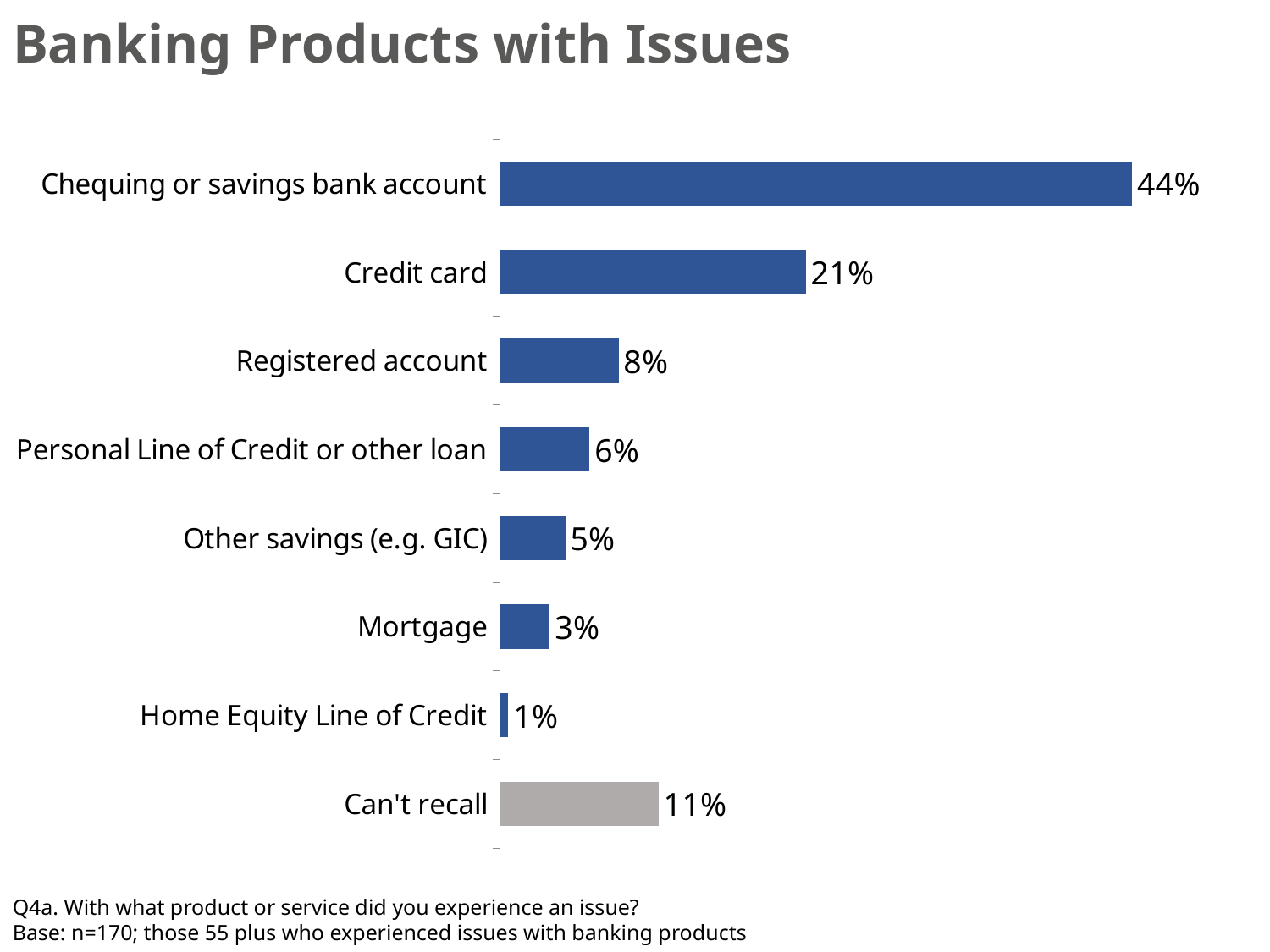
What is the difference between the values for Chequing or savings bank account and Credit card? 23% What is the value for Mortgage? 3% What percentage is shown for Can't recall? 11% What type of chart is shown on the slide? Bar chart What is the difference between Registered account and Other savings (e.g. GIC)? 3% What is the value for Credit card? 21% What percentage is shown for Chequing or savings bank account? 44% How many categories are shown on the chart? 8 Which banking product has the highest percentage of issues? Chequing or savings bank account What is the title of the chart? Banking Products with Issues Which category has the lowest value on the chart? Home Equity Line of Credit Which is larger, the value for Personal Line of Credit or other loan or the value for Mortgage? Personal Line of Credit or other loan